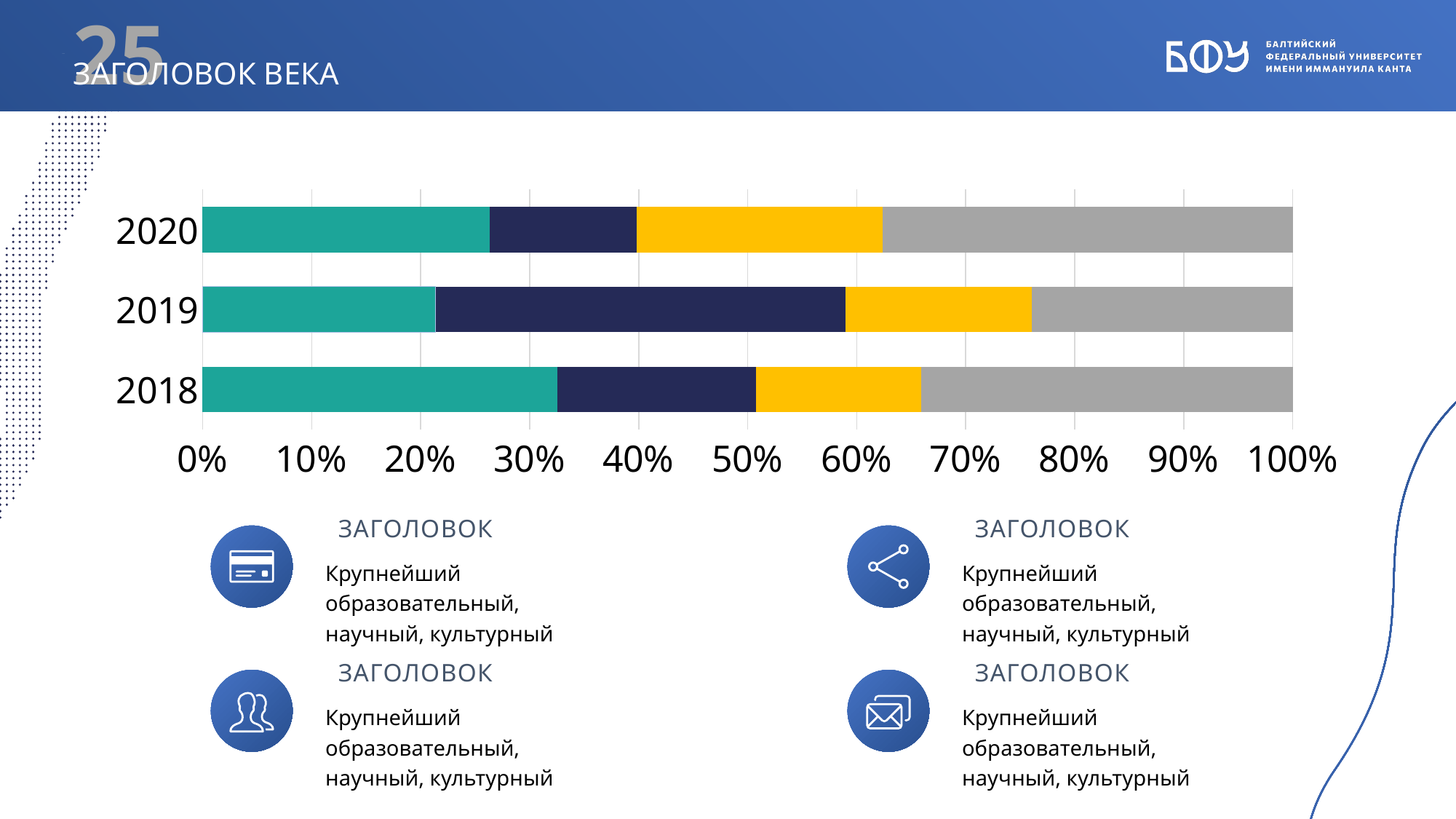
Which year has the largest yellow (third) segment? 2020 Which year has the largest teal (first) segment? 2018 What kind of chart is shown on the slide? stacked bar chart What is the title shown above the chart on the slide? ЗАГОЛОВОК ВЕКА How many years (categories) are plotted on the chart? 3 Is the teal segment for 2018 greater or less than 30%? greater How many coloured segments make up each bar in the chart? 4 Is the teal segment for 2019 greater or less than 30%? less Which year has the largest dark navy (second) segment? 2019 What is the total of the stacked bar for 2020? 100% Is the dark navy segment for 2019 greater or less than 30%? greater Which year has the smallest teal (first) segment? 2019